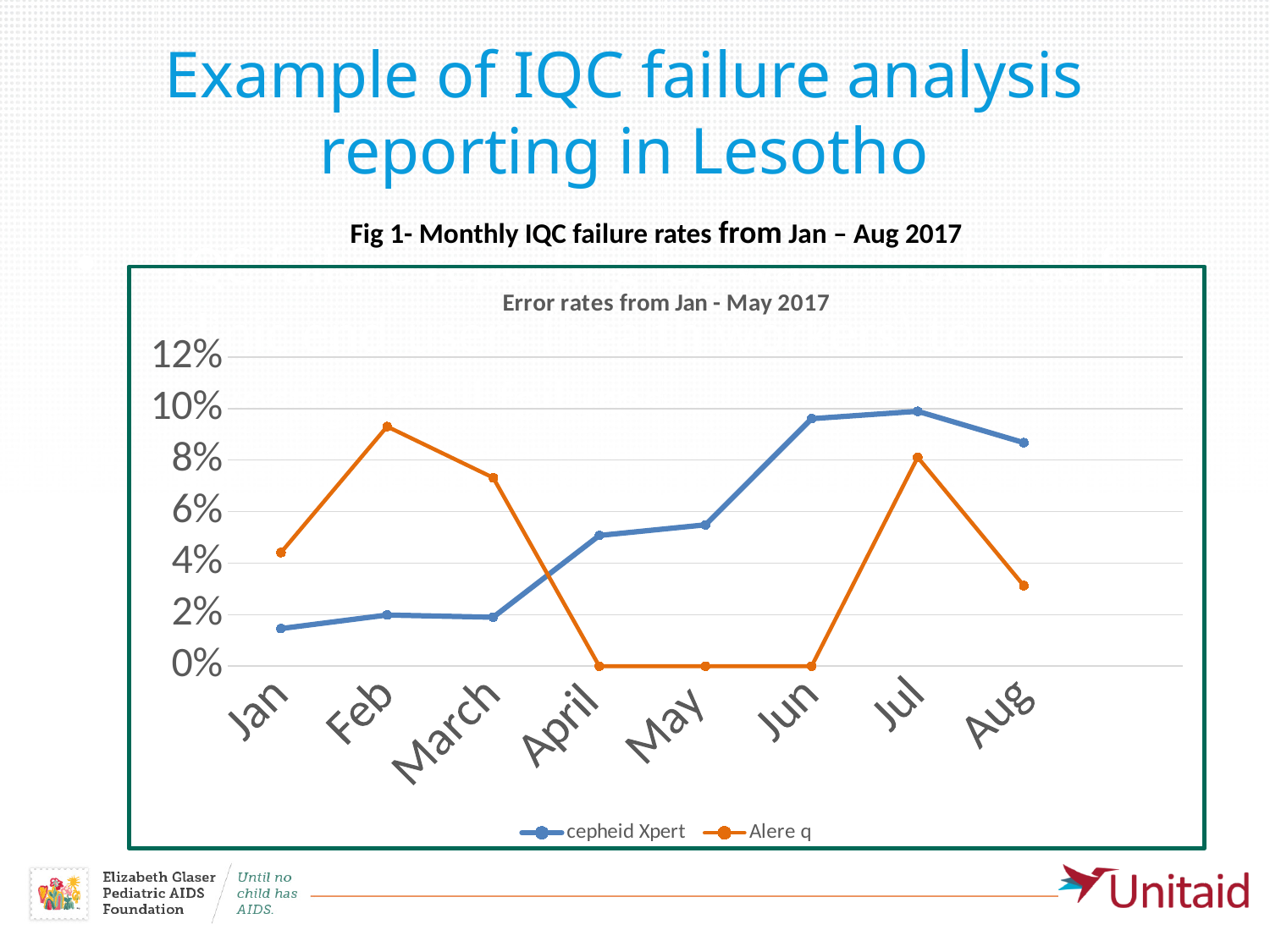
Is the Alere q value for Aug greater or less than 4%? less In which month is the cepheid Xpert failure rate lowest? Jan What kind of chart is shown on the slide? line chart How many months are plotted along the x axis? 8 What is the title printed inside the chart area? Error rates from Jan - May 2017 Is the cepheid Xpert value for Jun greater or less than 8%? greater In Jun, which series has the higher failure rate, cepheid Xpert or Alere q? cepheid Xpert What is the Alere q failure rate in Jun? 0% In Feb, which series has the higher failure rate, cepheid Xpert or Alere q? Alere q In which month is the Alere q failure rate highest? Feb How many series does the legend list? 2 What is the Alere q failure rate in April? 0%